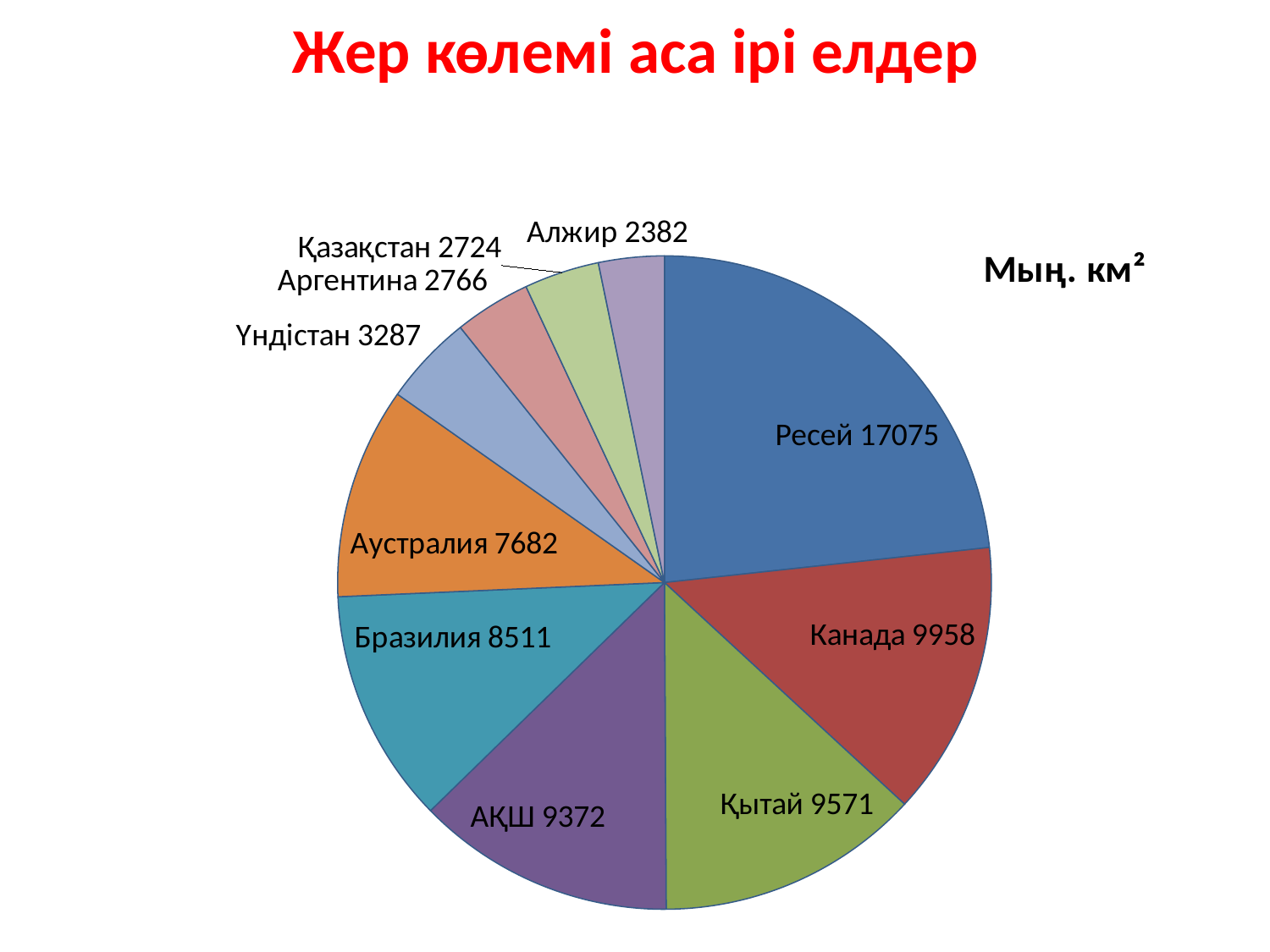
What is the value for Қазақстан in the pie chart? 2724 How many countries are shown in the pie chart? 10 What unit is indicated next to the pie chart? Мың. км² Which country has the largest slice in the pie chart? Ресей What type of chart is shown on the slide? pie chart What is the value for Бразилия in the pie chart? 8511 What is the value for Канада in the pie chart? 9958 What is the value for Ресей in the pie chart? 17075 What is the difference between the values for Ресей and Канада? 7117 Which country has the smallest slice in the pie chart? Алжир What is the difference between the values for Аустралия and Үндістан? 4395 Which is larger, the value for Қытай or the value for АҚШ? Қытай